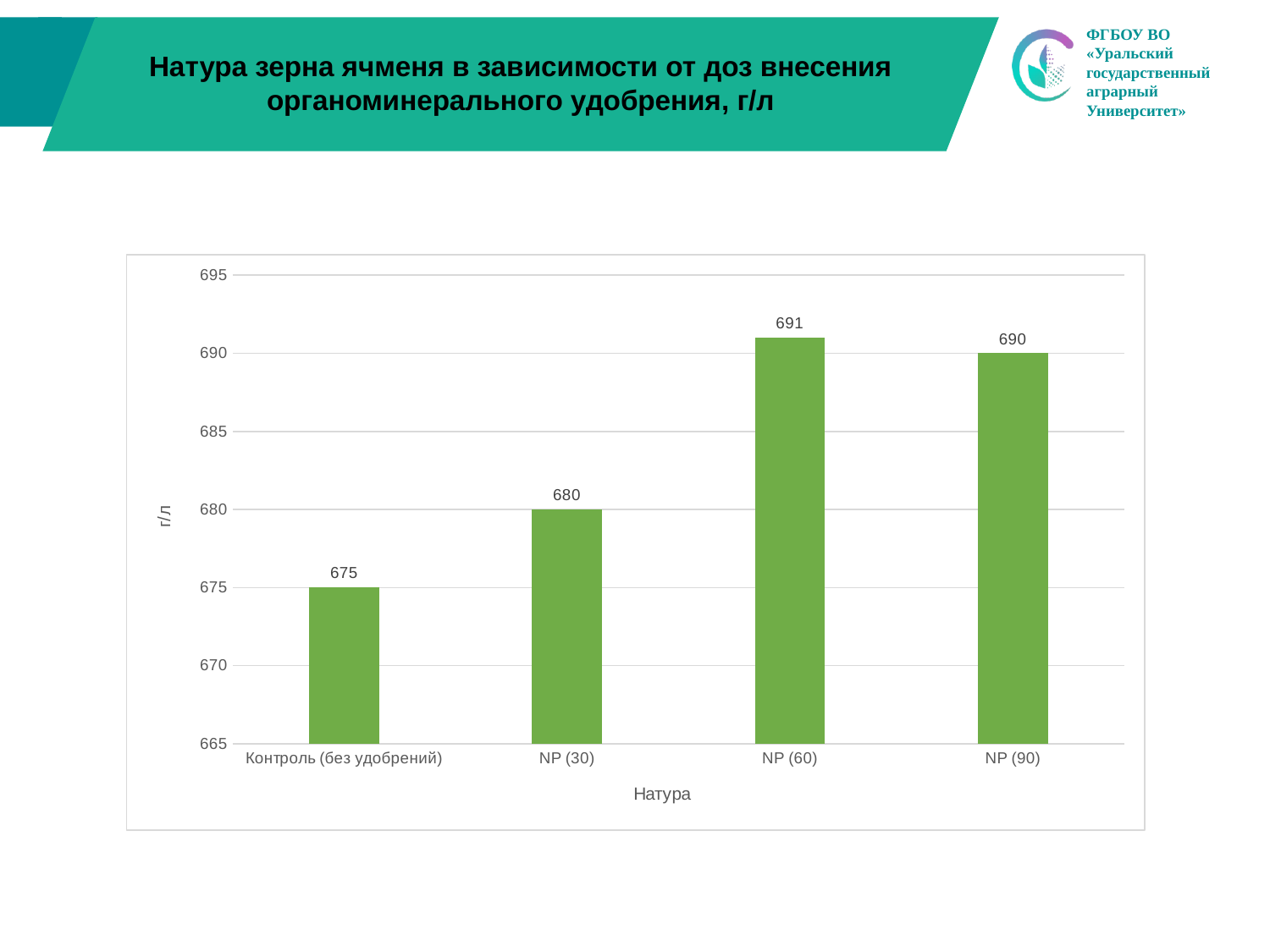
What kind of chart is shown on the slide? bar chart What is the difference between the values for NP (60) and Контроль (без удобрений)? 16 Which is larger, the value for NP (30) or the value for NP (90)? NP (90) What is the value for Контроль (без удобрений)? 675 Which category has the highest value? NP (60) What is the value for NP (30)? 680 Which category has the lowest value? Контроль (без удобрений) What is the value for NP (60)? 691 What is the value for NP (90)? 690 What is the label of the y axis? г/л What is the difference between the values for NP (30) and Контроль (без удобрений)? 5 How many categories are shown on the x axis? 4